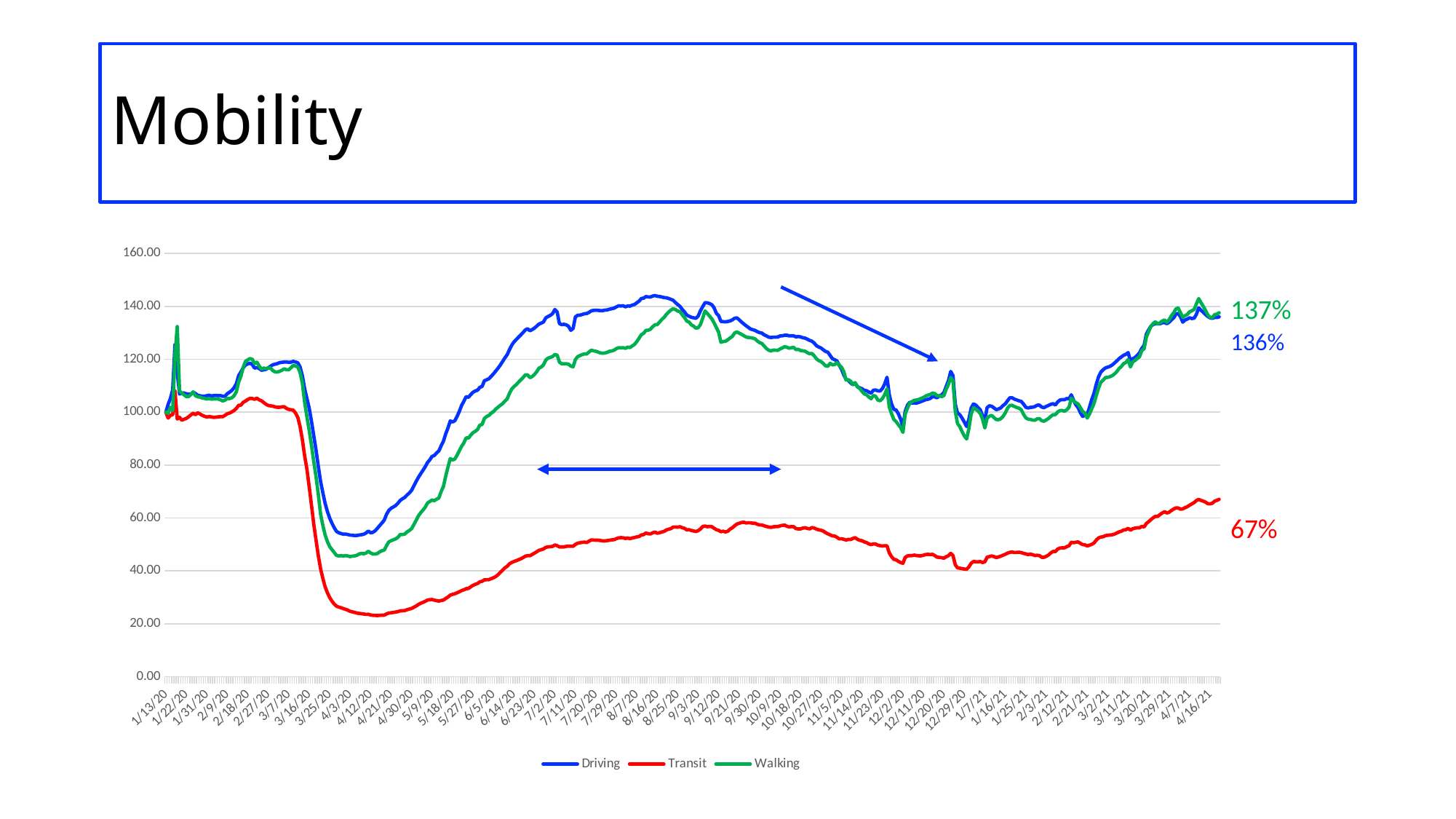
Which series has the highest labelled value at the end of the chart? Walking Which series has the lowest labelled value at the end of the chart? Transit How many series does the legend list? 3 What kind of chart is shown on the slide? Line chart What is the final labelled value for the Driving series? 136% At the end of the chart, which labelled value is larger: Driving or Transit? Driving What is the final labelled value for the Transit series? 67% Does the Transit line rise or fall between 3/7/20 and 4/3/20? Falls What is the final labelled value for the Walking series? 137% What is the difference between the final labelled values for Walking and Transit? 70 percentage points Is the value for Transit around 4/3/20 greater or less than 40? less What colour is the Transit line in the legend? Red